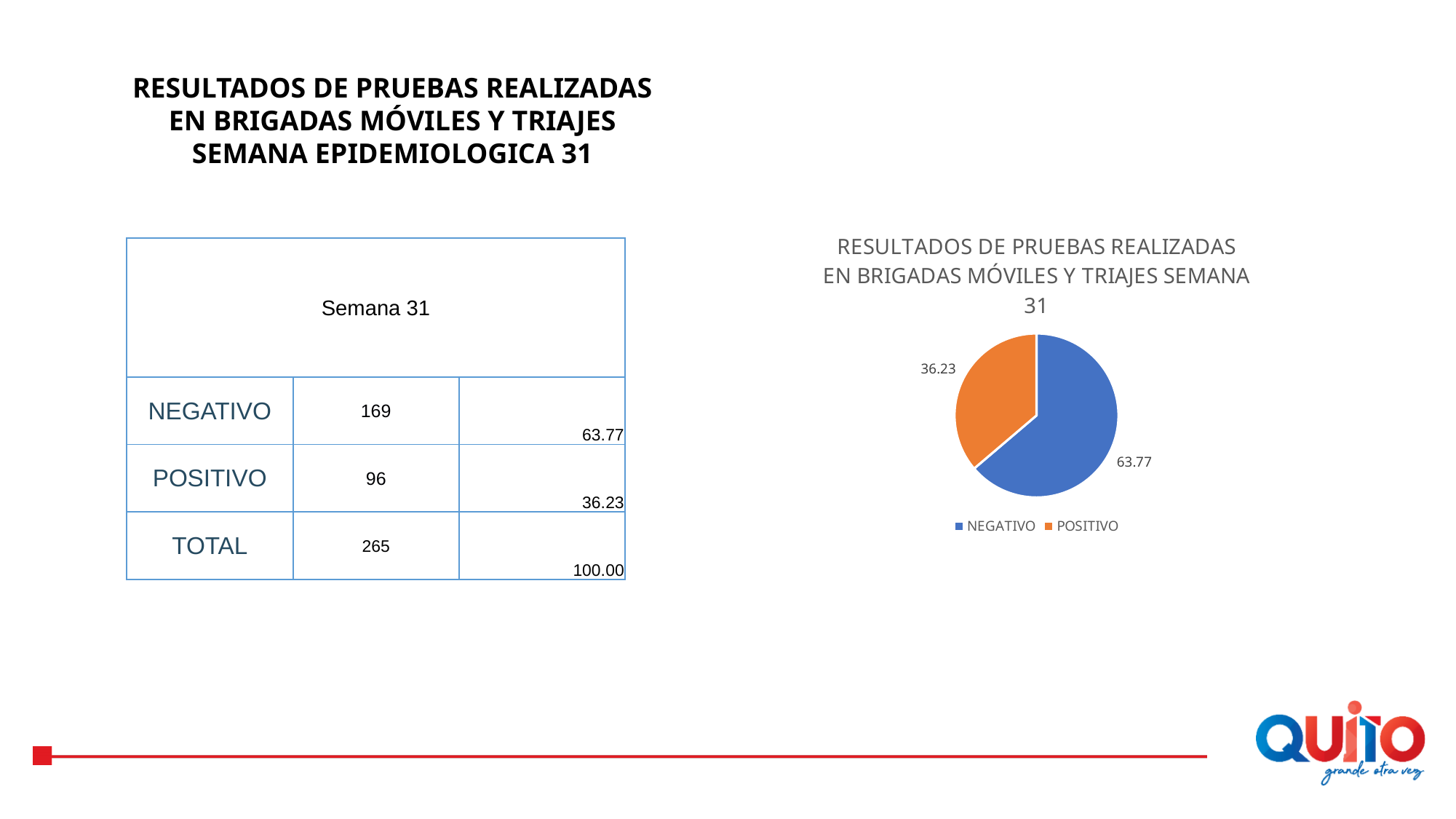
What value is shown for the NEGATIVO slice of the pie chart? 63.77 What value is shown for the POSITIVO slice of the pie chart? 36.23 Which is larger in the pie chart, NEGATIVO or POSITIVO? NEGATIVO What kind of chart is shown on the slide? pie chart Which slice of the pie chart is the largest? NEGATIVO What colour is the POSITIVO slice in the pie chart? orange How many slices does the pie chart have? 2 Which slice of the pie chart is the smallest? POSITIVO How many entries does the pie chart legend list? 2 What is the difference between the NEGATIVO and POSITIVO values in the pie chart? 27.54 What colour is the NEGATIVO slice in the pie chart? blue